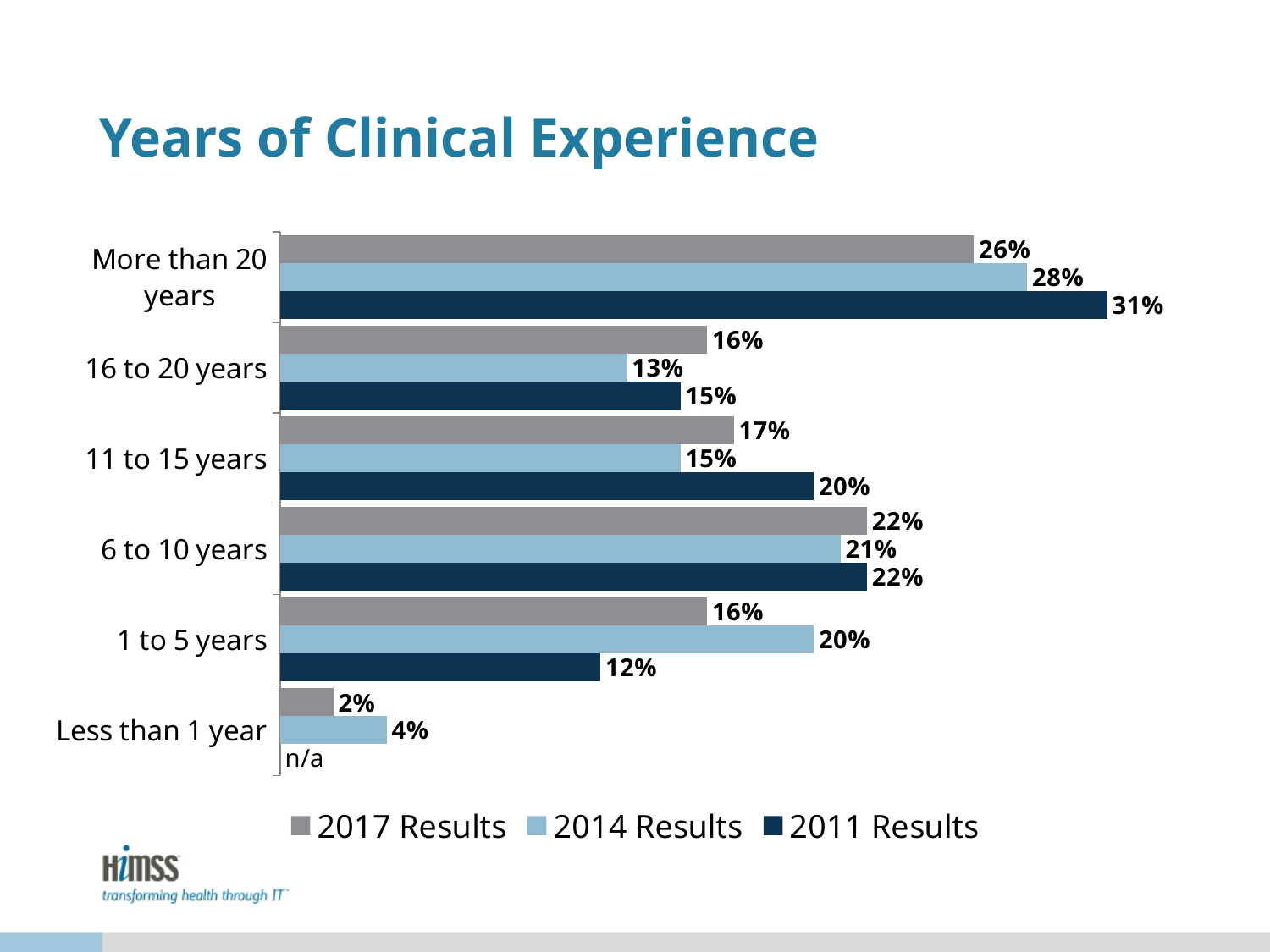
How many categories are shown on the y axis? 6 What is the 2014 Results value for 16 to 20 years? 13% What is shown for the 2011 Results value for Less than 1 year? n/a How many series does the legend list? 3 What is the 2017 Results value for More than 20 years? 26% What is the 2011 Results value for 1 to 5 years? 12% What is the difference between the 2011 Results and 2017 Results values for More than 20 years? 5% Which category has the lowest 2017 Results value? Less than 1 year Which is larger for 1 to 5 years: the 2014 Results value or the 2011 Results value? 2014 Results Which category has the highest 2011 Results value? More than 20 years What is the title of the chart? Years of Clinical Experience What kind of chart is shown on the slide? Bar chart